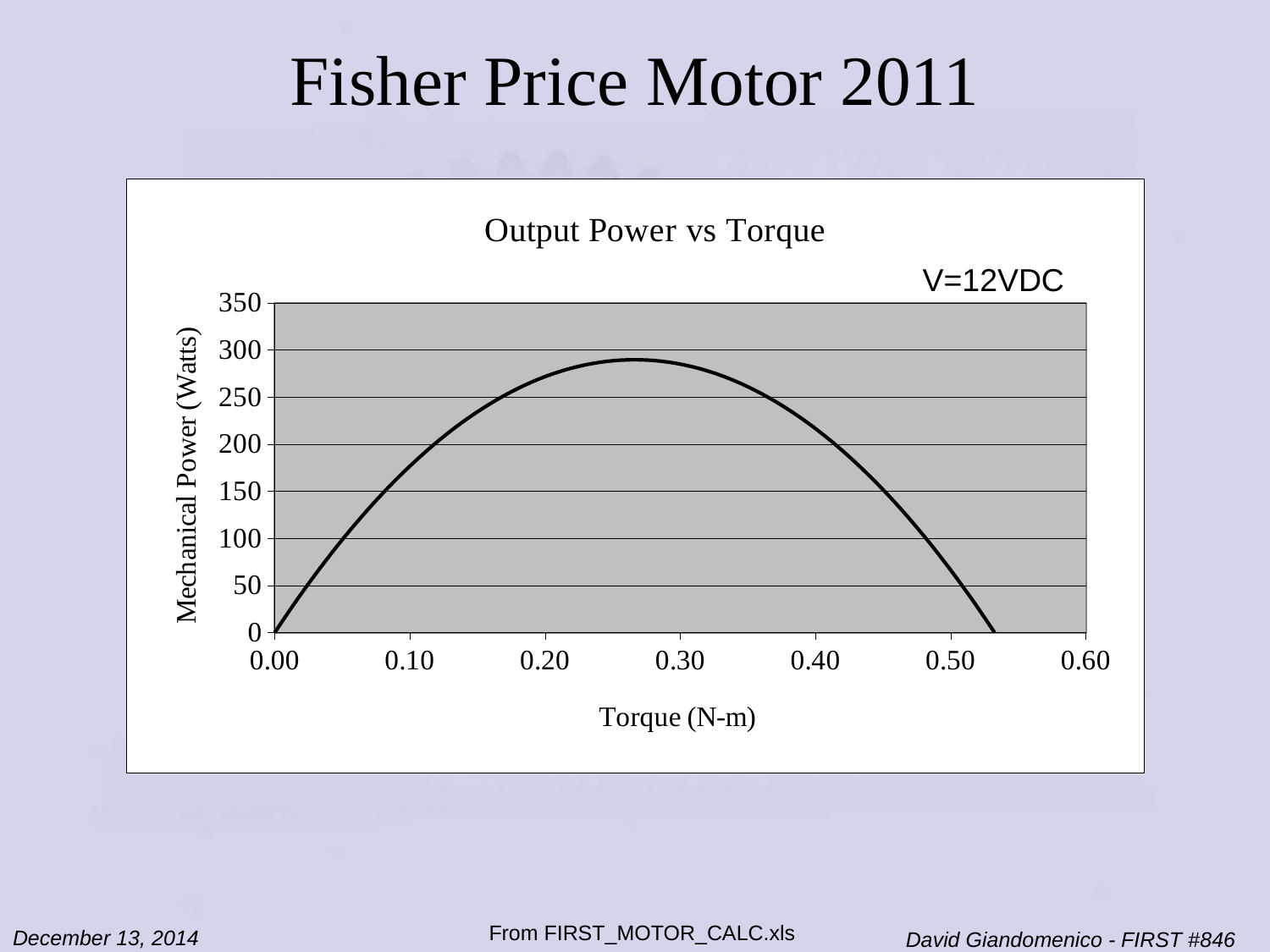
Which torque has the higher mechanical power, 0.20 N-m or 0.50 N-m? 0.20 N-m Is the mechanical power at a torque of 0.50 N-m greater or less than 100? less How does mechanical power change as torque increases from 0.00 to 0.60 N-m? rises then falls What is the title of the chart? Output Power vs Torque Is the mechanical power at a torque of 0.10 N-m greater or less than 200? less What voltage is noted on the chart? V=12VDC Is the mechanical power at a torque of 0.40 N-m greater or less than 150? greater What kind of chart is shown on the slide? line chart What is the mechanical power at a torque of 0.00 N-m? 0